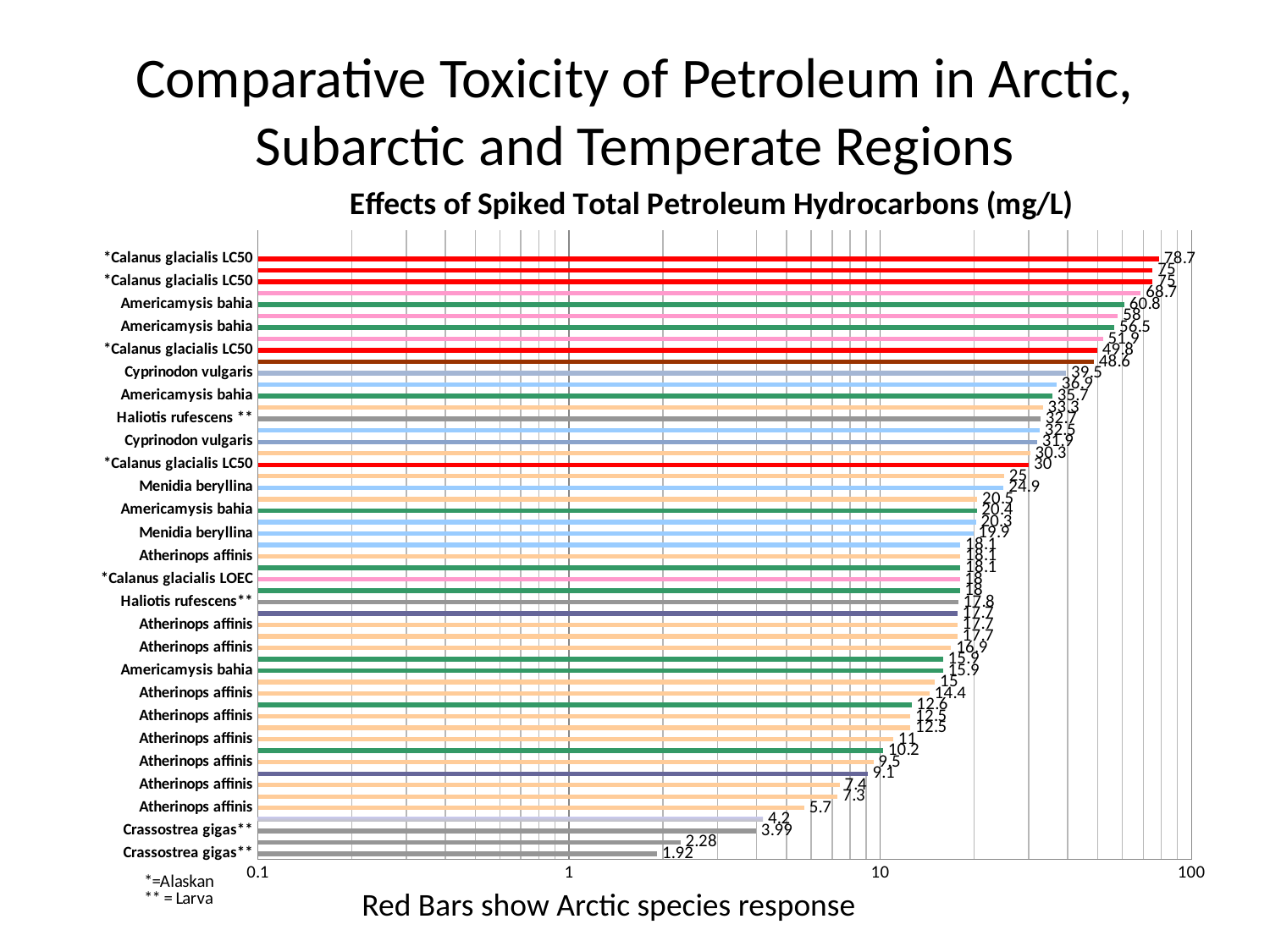
Which is larger: the topmost *Calanus glacialis LC50 bar or the bottom Crassostrea gigas** bar? *Calanus glacialis LC50 According to the slide, what do the red bars show? Arctic species response What is the highest value shown in the chart? 78.7 What is the value of the bottom bar, labelled Crassostrea gigas**? 1.92 What is the value of the topmost bar, labelled *Calanus glacialis LC50? 78.7 What is the difference between the highest value (78.7) and the lowest value (1.92)? 76.78 What is the title of the chart? Effects of Spiked Total Petroleum Hydrocarbons (mg/L) Is the value of the topmost *Calanus glacialis LC50 bar greater or less than 100? less Is the value of the bottom Crassostrea gigas** bar greater or less than 1? greater What is the lowest value shown in the chart? 1.92 What kind of chart is shown on the slide? bar chart What is the difference between the topmost *Calanus glacialis LC50 bar (78.7) and the second labelled *Calanus glacialis LC50 bar (75)? 3.7